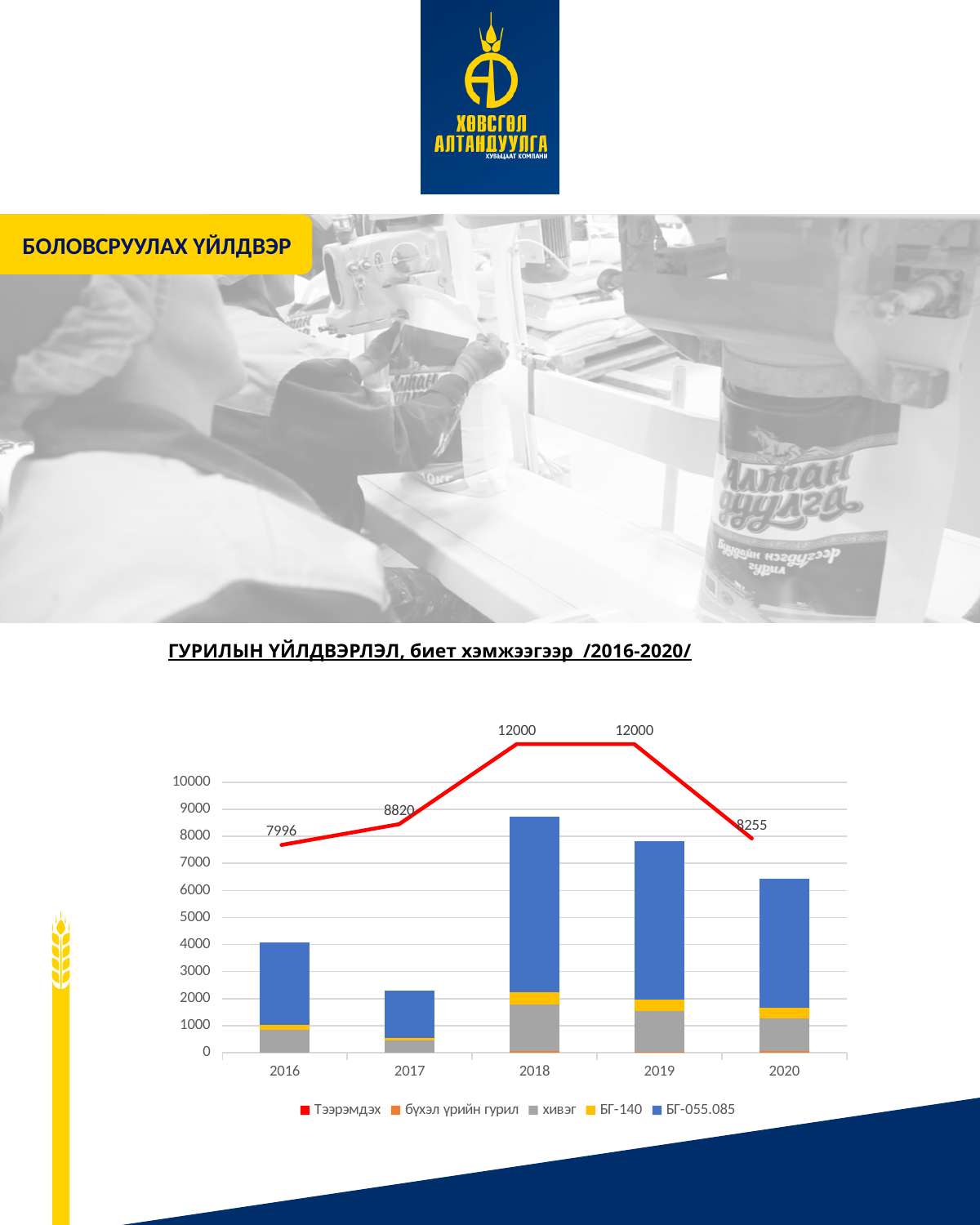
How many series does the chart legend list? 5 Which year has the larger Тээрэмдэх value, 2017 or 2020? 2017 Does the Тээрэмдэх line rise or fall from 2016 to 2018? rise In which year is the Тээрэмдэх line value lowest? 2016 How many years are shown on the x axis of the chart? 5 What is the difference between the Тээрэмдэх values for 2017 and 2016? 824 By how much does the Тээрэмдэх value fall from 2019 to 2020? 3745 Is the total height of the stacked bar for 2017 greater or less than 3000? less Is the total height of the stacked bar for 2018 greater or less than 8000? greater What is the value of the Тээрэмдэх line for 2016? 7996 What is the value of the Тээрэмдэх line for 2017? 8820 What is the value of the Тээрэмдэх line for 2020? 8255